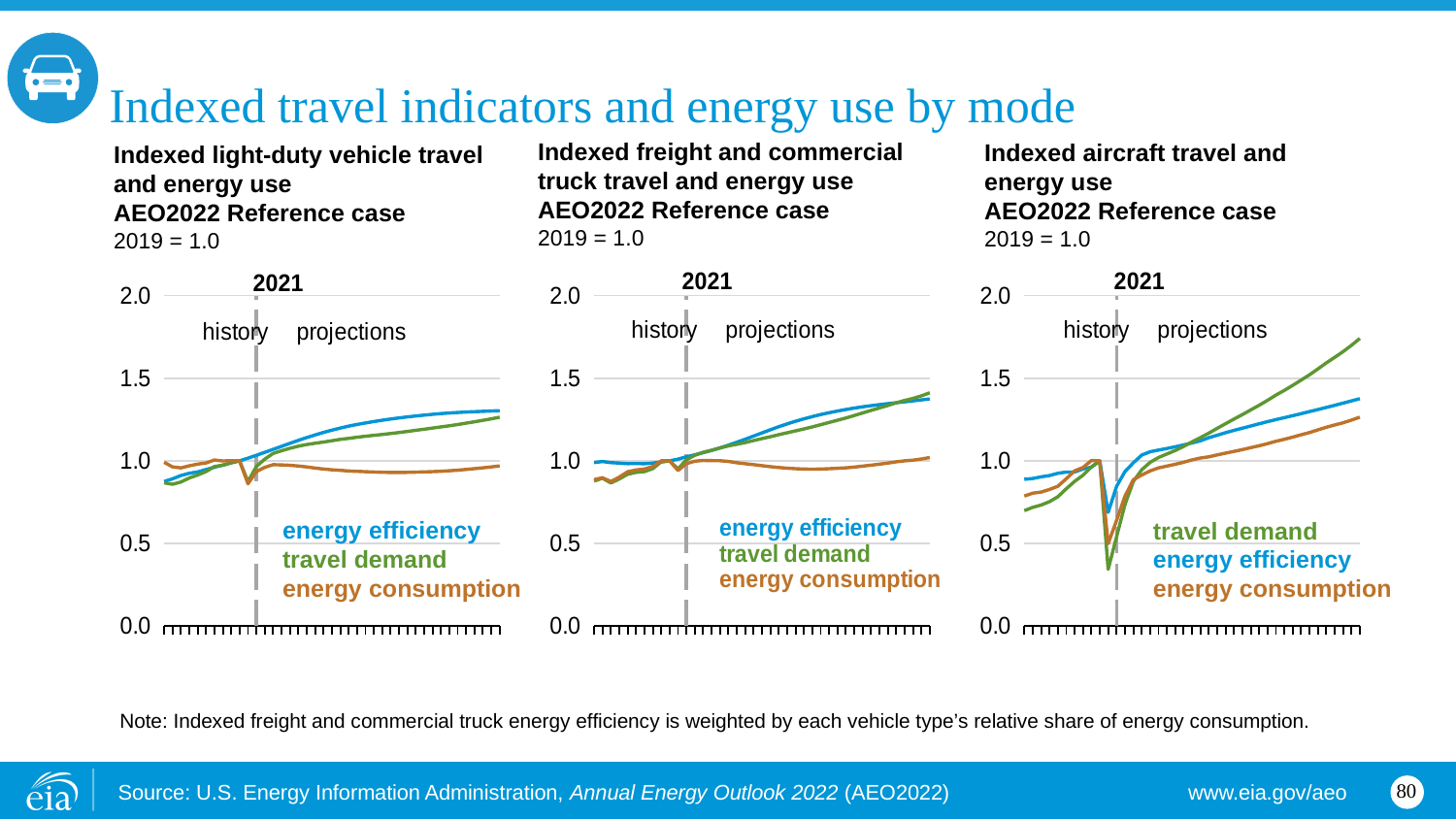
In the 'Indexed aircraft travel and energy use' chart, does travel demand rise or fall over the projection period? rise What kind of chart is the 'Indexed light-duty vehicle travel and energy use' chart? line chart In the 'Indexed aircraft travel and energy use' chart, which series is higher at the end of the projection period: travel demand or energy consumption? travel demand What year does the dashed vertical line separating history from projections mark in each chart? 2021 How many series are plotted in the 'Indexed aircraft travel and energy use' chart? 3 In the 'Indexed aircraft travel and energy use' chart, is the final projected value for travel demand greater or less than 1.5? greater What base year is set equal to 1.0 in the indexed charts? 2019 How many charts are shown on the slide? 3 In the 'Indexed aircraft travel and energy use' chart, is the lowest value of travel demand (the dip around 2020) greater or less than 0.5? less In the 'Indexed light-duty vehicle travel and energy use' chart, is the final projected value for energy consumption greater or less than 1.0? less In the 'Indexed light-duty vehicle travel and energy use' chart, which series is higher at the end of the projection period: energy efficiency or energy consumption? energy efficiency